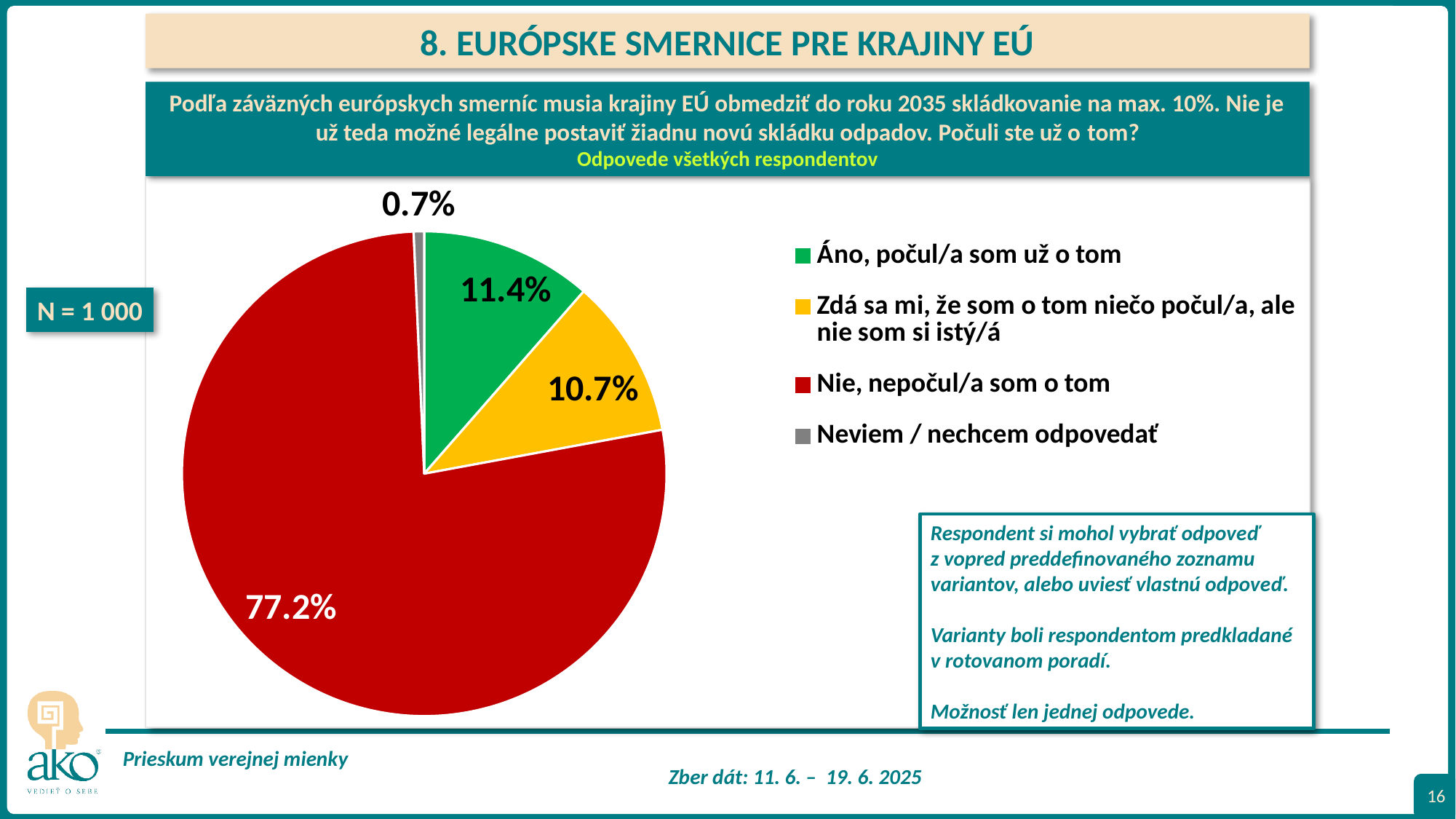
What is the difference in percentage points between "Nie, nepočul/a som o tom" and "Áno, počul/a som už o tom"? 65.8 What share of respondents answered "Zdá sa mi, že som o tom niečo počul/a, ale nie som si istý/á"? 10.7% What share of respondents answered "Neviem / nechcem odpovedať"? 0.7% Which answer has the largest share of the pie? Nie, nepočul/a som o tom What is the sample size (N) shown on the slide? N = 1 000 What share of respondents answered "Áno, počul/a som už o tom"? 11.4% Which answer has the smallest share of the pie? Neviem / nechcem odpovedať What share of respondents answered "Nie, nepočul/a som o tom"? 77.2% How many slices does the pie chart have? 4 What colour is the slice for "Nie, nepočul/a som o tom"? red Which is larger: the share for "Áno, počul/a som už o tom" or for "Zdá sa mi, že som o tom niečo počul/a, ale nie som si istý/á"? Áno, počul/a som už o tom What kind of chart is shown on the slide? pie chart